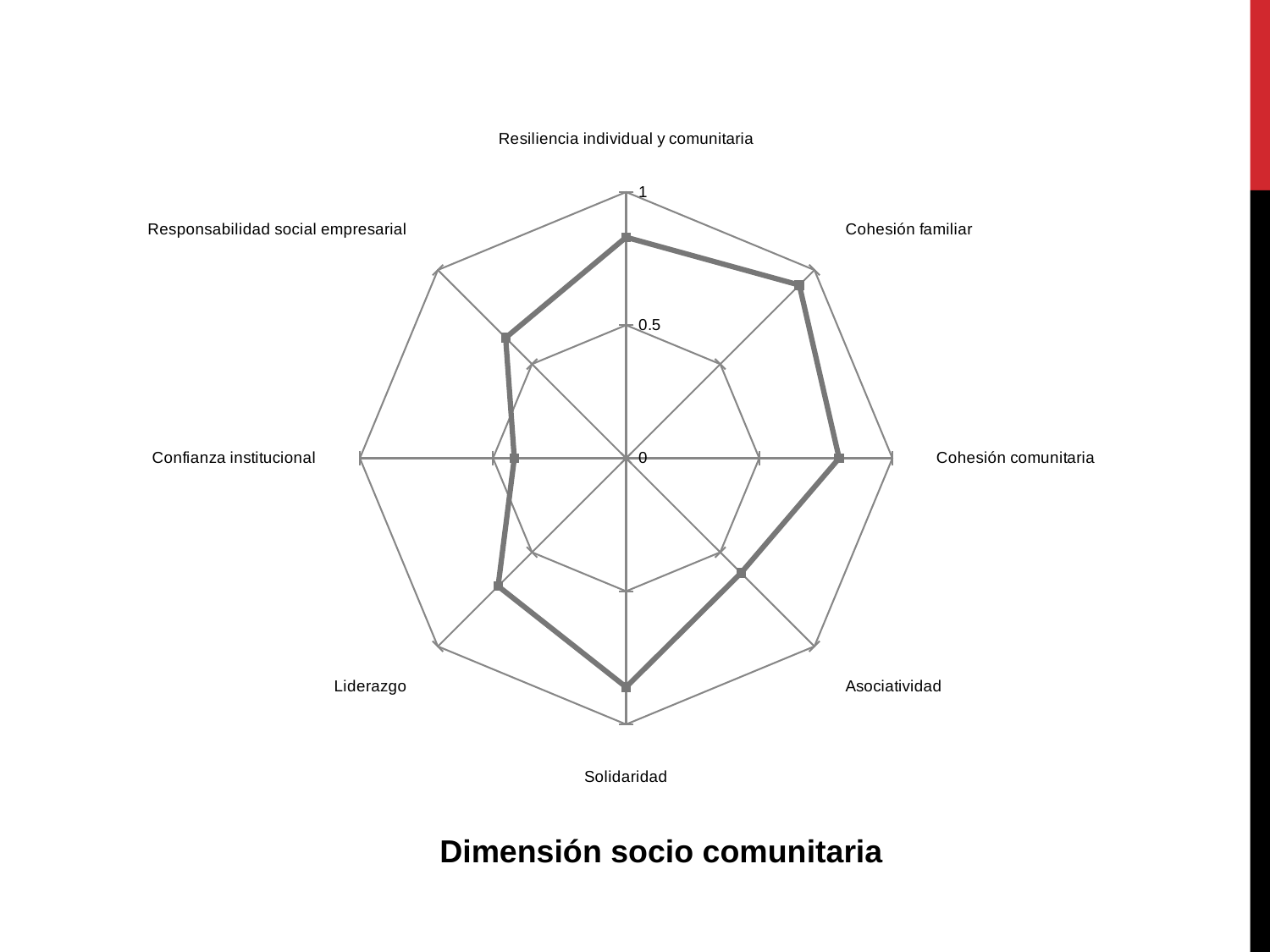
Is the value for Cohesión familiar greater or less than 0.5? greater Which category has the lowest value on the chart? Confianza institucional Which is larger, the value for Cohesión familiar or the value for Confianza institucional? Cohesión familiar Is the value for Solidaridad greater or less than 0.5? greater What is the title of the chart? Dimensión socio comunitaria What is the maximum value shown on the chart's axis scale? 1 Is the value for Confianza institucional greater or less than 0.5? less Which is larger, the value for Solidaridad or the value for Asociatividad? Solidaridad How many categories (axes) does the radar chart have? 8 What kind of chart is shown on the slide? Radar chart Which is larger, the value for Liderazgo or the value for Confianza institucional? Liderazgo